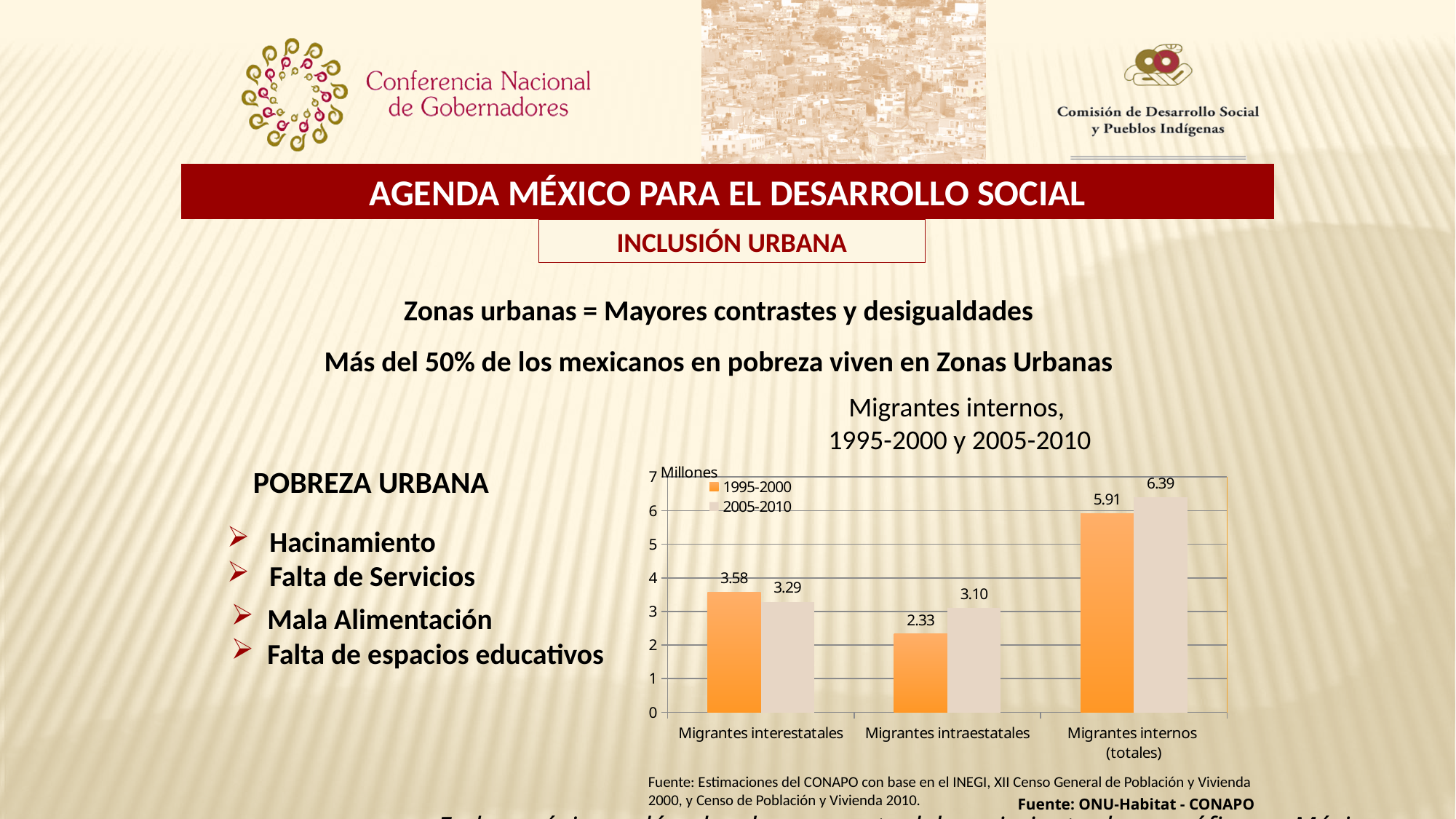
What is the value for Migrantes interestatales in the 1995-2000 series? 3.58 Which category has the highest value in the 1995-2000 series? Migrantes internos (totales) What is the value for Migrantes intraestatales in the 2005-2010 series? 3.10 Which category has the lowest value in the 2005-2010 series? Migrantes intraestatales What kind of chart is shown on the slide? bar chart How many series does the chart legend list? 2 What is the value for Migrantes internos (totales) in the 2005-2010 series? 6.39 How many categories are shown on the x axis of the chart? 3 What unit is indicated on the y axis of the chart? Millones For Migrantes interestatales, which series has the larger value, 1995-2000 or 2005-2010? 1995-2000 What is the difference between the 2005-2010 and 1995-2000 values for Migrantes internos (totales)? 0.48 Is the 1995-2000 value for Migrantes intraestatales greater or less than 3? less